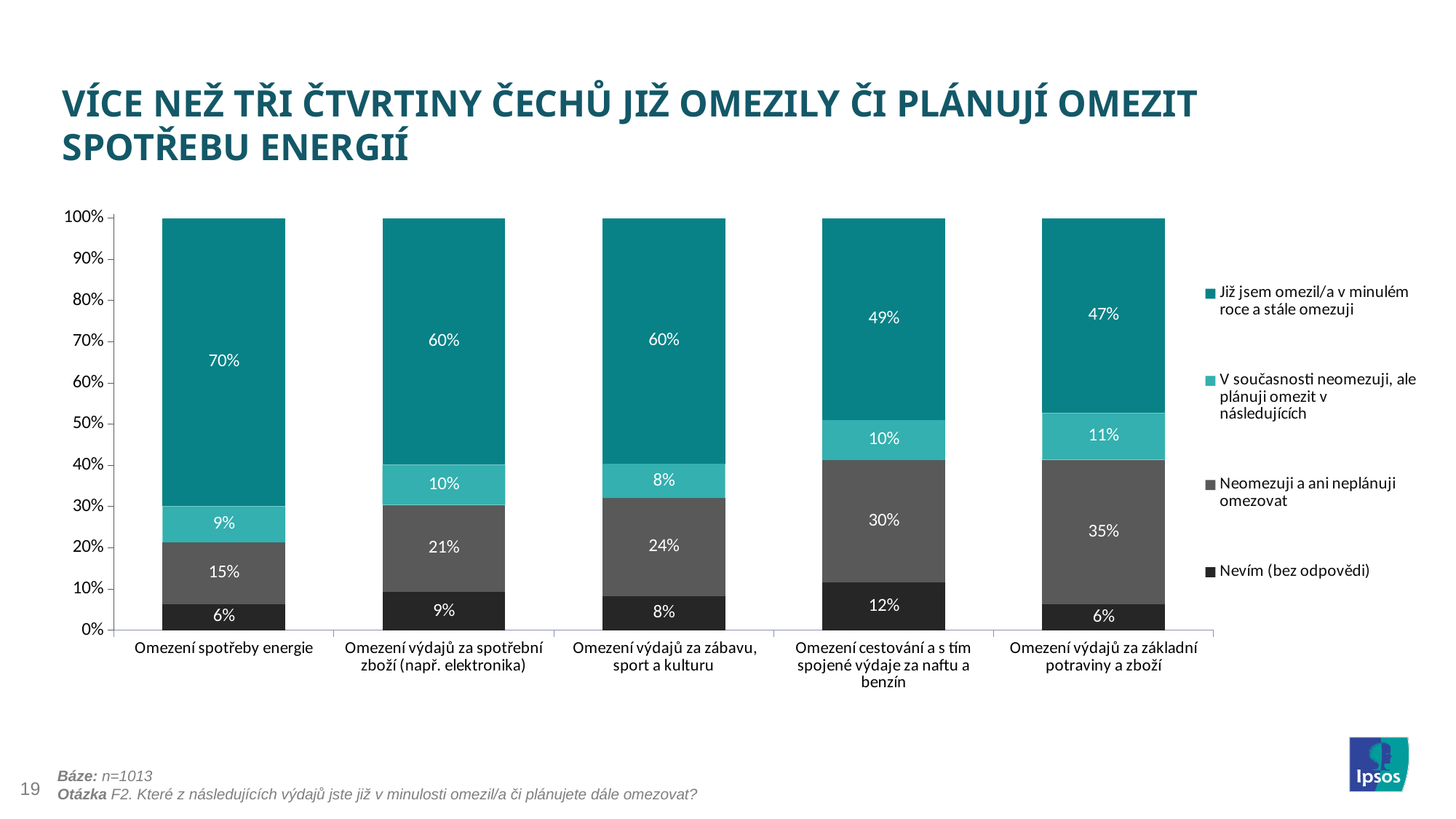
What percentage of respondents said they have already limited ("Již jsem omezil/a v minulém roce a stále omezuji") for "Omezení spotřeby energie"? 70% How many series does the legend list? 4 Which category has the highest share of "Již jsem omezil/a v minulém roce a stále omezuji"? Omezení spotřeby energie What is the value of "Neomezuji a ani neplánuji omezovat" for "Omezení výdajů za základní potraviny a zboží"? 35% What is the difference between the "Již jsem omezil/a v minulém roce a stále omezuji" values for "Omezení spotřeby energie" and "Omezení výdajů za základní potraviny a zboží"? 23 percentage points What is the combined share of "Již jsem omezil/a v minulém roce a stále omezuji" and "V současnosti neomezuji, ale plánuji omezit v následujících" for "Omezení spotřeby energie"? 79% Which is larger: the "Neomezuji a ani neplánuji omezovat" value for "Omezení cestování a s tím spojené výdaje za naftu a benzín" or for "Omezení výdajů za spotřební zboží (např. elektronika)"? Omezení cestování a s tím spojené výdaje za naftu a benzín Which category has the lowest share of "Neomezuji a ani neplánuji omezovat"? Omezení spotřeby energie What is the value of "V současnosti neomezuji, ale plánuji omezit v následujících" for "Omezení výdajů za zábavu, sport a kulturu"? 8% What is the value of "Nevím (bez odpovědi)" for "Omezení cestování a s tím spojené výdaje za naftu a benzín"? 12% How many categories are shown on the x axis of the chart? 5 What type of chart is shown on the slide? Stacked bar chart